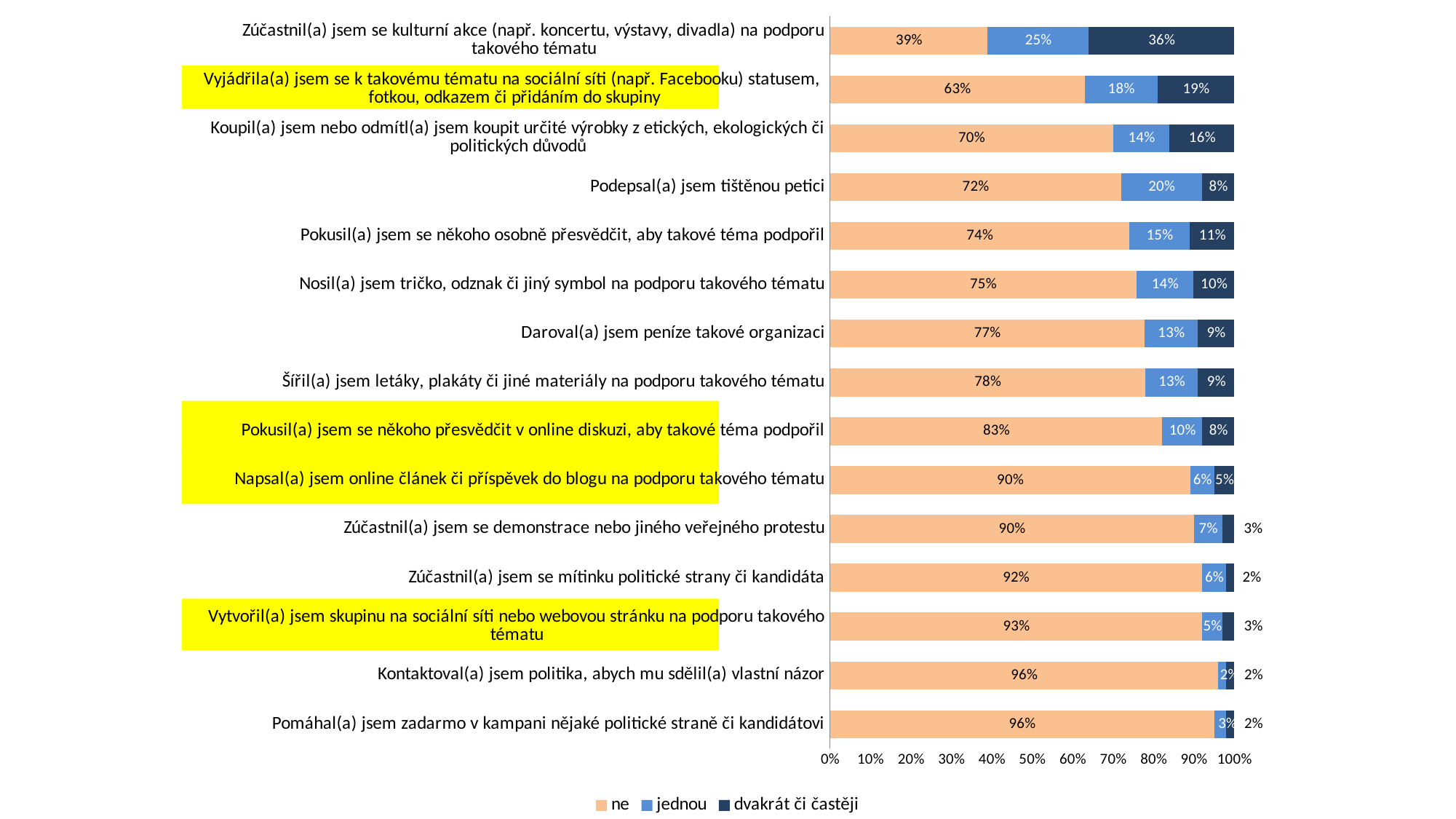
Which category has the highest 'jednou' value? Zúčastnil(a) jsem se kulturní akce (např. koncertu, výstavy, divadla) na podporu takového tématu What is the 'ne' value for 'Podepsal(a) jsem tištěnou petici'? 72% What is the 'dvakrát či častěji' value for 'Zúčastnil(a) jsem se kulturní akce (např. koncertu, výstavy, divadla) na podporu takového tématu'? 36% What is the difference between the 'ne' values for 'Koupil(a) jsem nebo odmítl(a) jsem koupit určité výrobky z etických, ekologických či politických důvodů' and 'Vyjádřila(a) jsem se k takovému tématu na sociální síti (např. Facebooku) statusem, fotkou, odkazem či přidáním do skupiny'? 7% What kind of chart is shown on the slide? stacked bar chart How many categories (statements) are plotted in the chart? 15 Which category has the lowest 'ne' value? Zúčastnil(a) jsem se kulturní akce (např. koncertu, výstavy, divadla) na podporu takového tématu What is the total of the stacked bar for 'Nosil(a) jsem tričko, odznak či jiný symbol na podporu takového tématu'? 99% Which series is shown in the darkest (navy) colour? dvakrát či častěji What is the 'jednou' value for 'Daroval(a) jsem peníze takové organizaci'? 13% How many series does the legend list? 3 Which is larger: the 'dvakrát či častěji' value for 'Podepsal(a) jsem tištěnou petici' or for 'Pokusil(a) jsem se někoho osobně přesvědčit, aby takové téma podpořil'? Pokusil(a) jsem se někoho osobně přesvědčit, aby takové téma podpořil